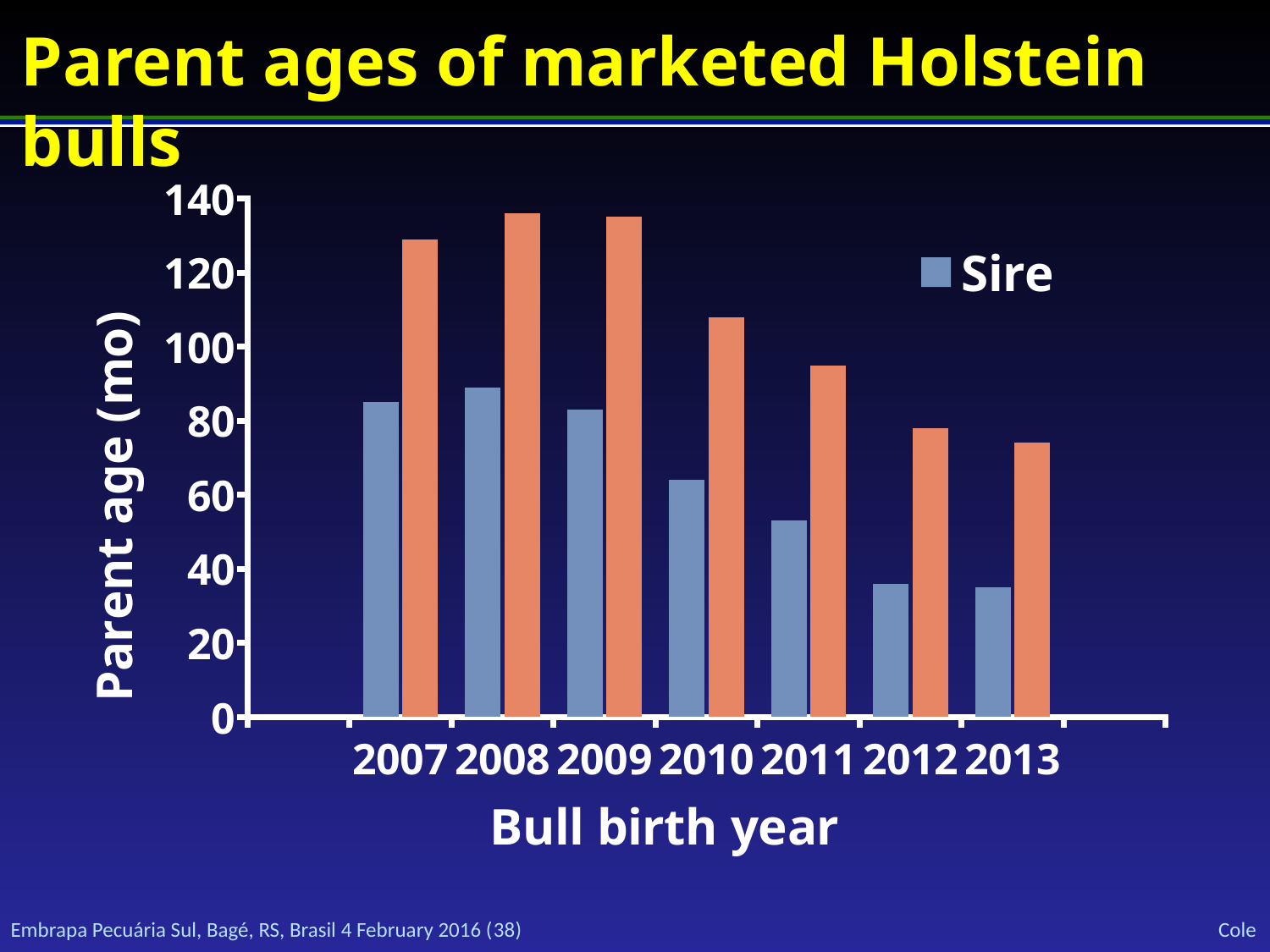
Do the Sire values generally rise or fall from 2007 to 2013? fall Is the orange bar for 2007 greater or less than 120? greater Is the Sire value for 2011 greater or less than 60? less Is the orange bar for 2013 greater or less than 80? less Which series name is shown in the legend? Sire What is the label on the y axis? Parent age (mo) How many bull birth years are shown on the x axis? 7 What kind of chart is shown on the slide? bar chart Which bull birth year has the highest Sire value? 2008